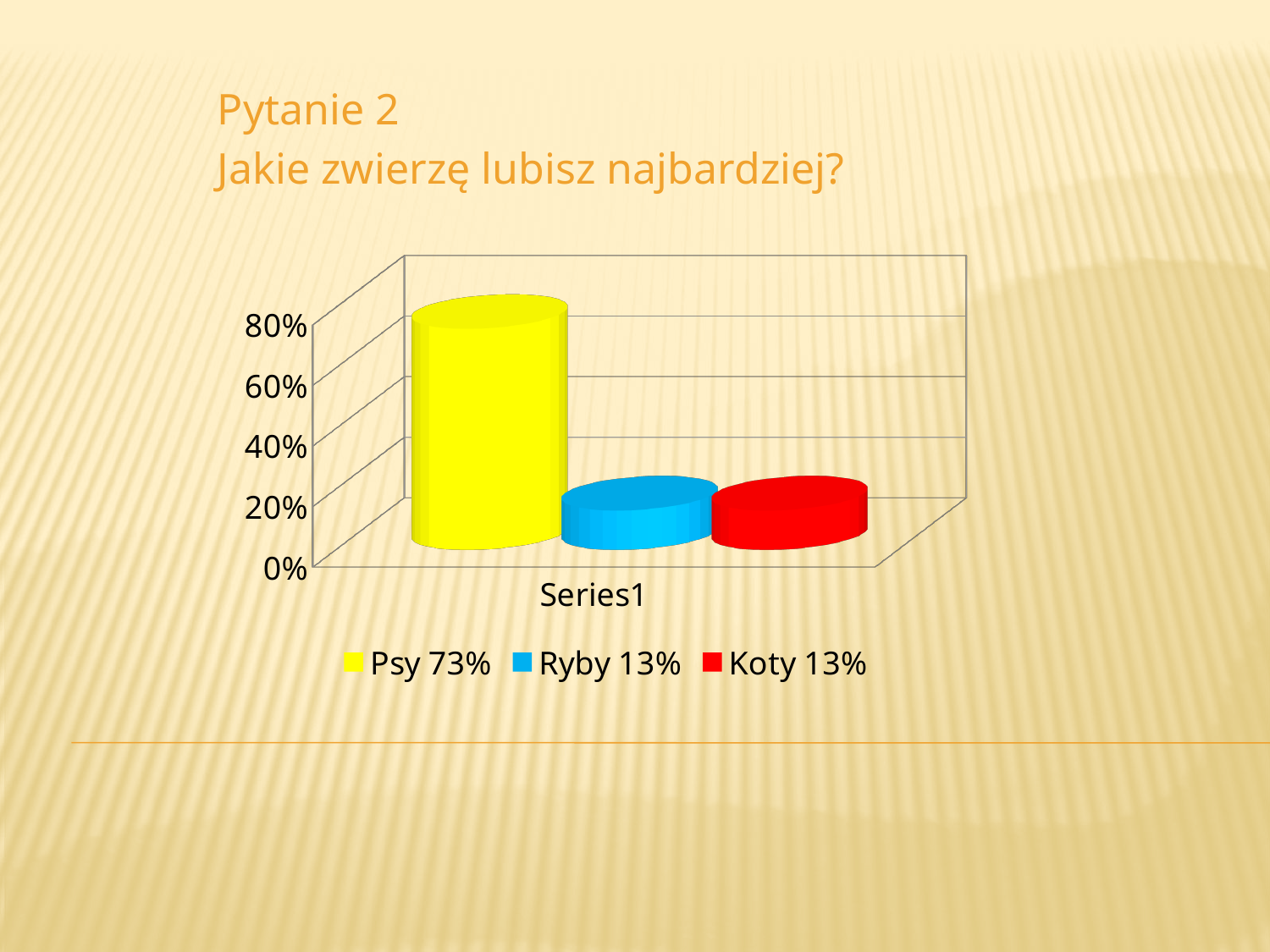
Which is larger, the value for Psy or the value for Koty? Psy How many series does the chart legend list? 3 What is the difference between the values for Psy and Ryby? 60% What percentage is shown for Koty in the chart legend? 13% Is the value for Ryby greater or less than 20%? less What kind of chart is shown on the slide? bar chart What percentage is shown for Ryby in the chart legend? 13% Is the value for Psy greater or less than 60%? greater What is the difference between the values for Psy and Koty? 60% What colour is the bar for Psy? yellow What percentage is shown for Psy in the chart legend? 73% Which animal has the highest value in the chart? Psy